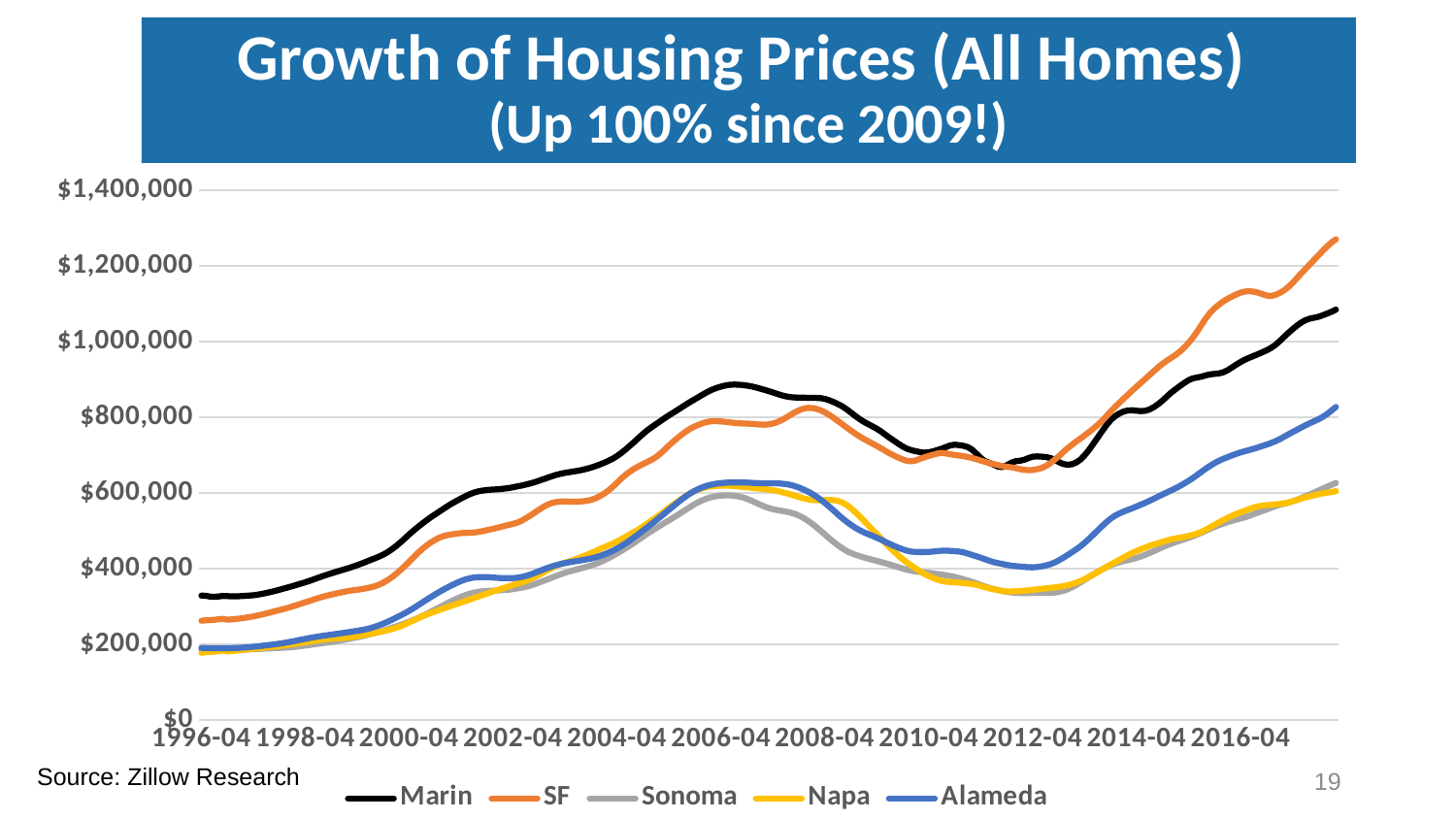
What is the title of the chart? Growth of Housing Prices (All Homes) (Up 100% since 2009!) Which series is plotted with the black line? Marin Is the value for Marin at the right end of the chart greater or less than $1,000,000? greater What kind of chart is shown on the slide? line chart Is the value for Napa at 1996-04 greater or less than $200,000? less Does the Marin line rise or fall from 2012-04 to the right end of the chart? rise Which series has the highest value at the right end of the chart? SF How many series does the legend list? 5 At 2006-04, which is higher, Marin or SF? Marin Is the value for SF at the right end of the chart greater or less than $1,200,000? greater Which series has the highest value at 1996-04? Marin